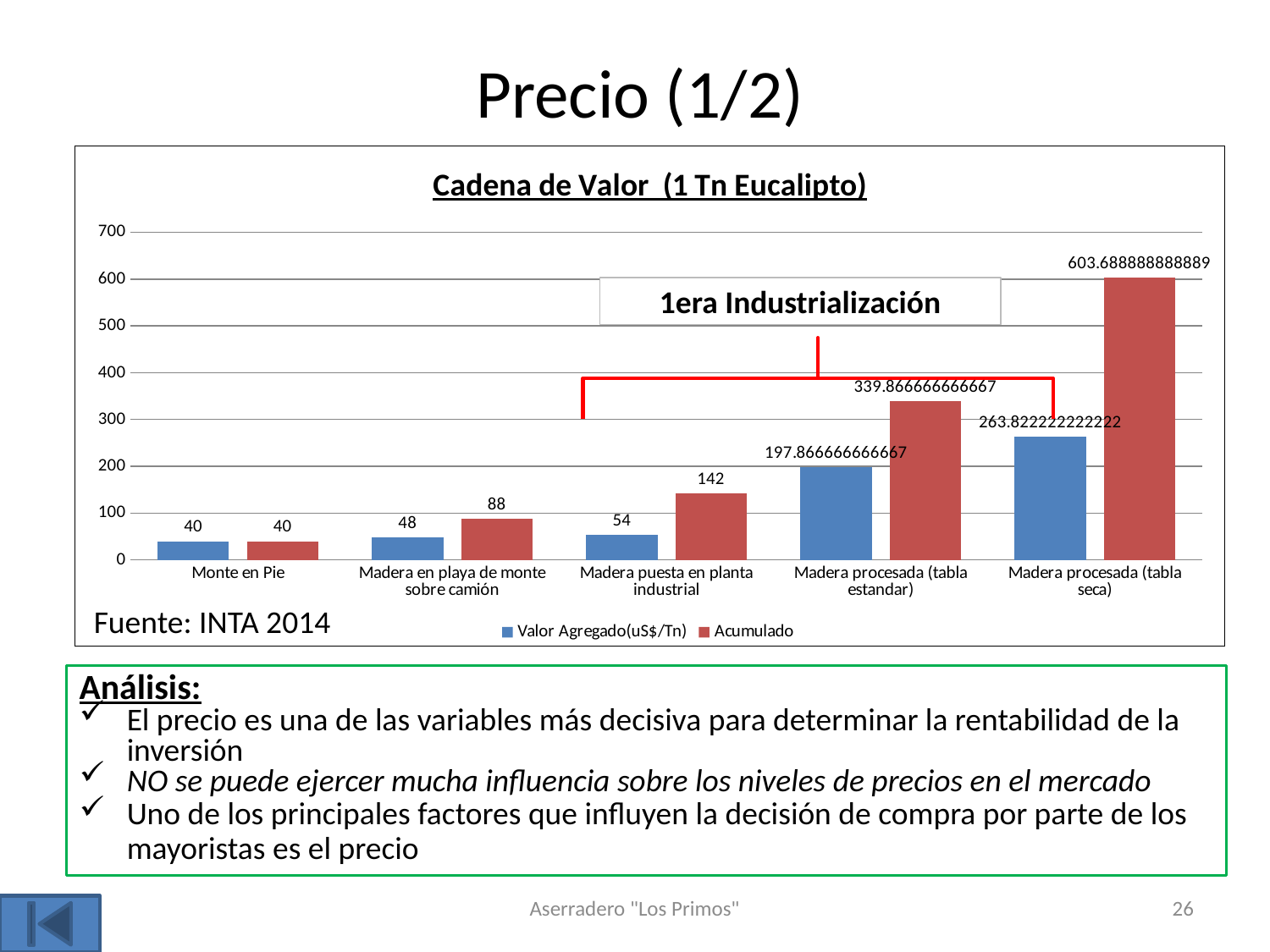
Do the Acumulado values rise or fall from left to right along the x axis? rise What type of chart is shown on the slide? bar chart What is the Acumulado value for Madera procesada (tabla seca)? 603.688888888889 Which category has the lowest Valor Agregado(uS$/Tn) value? Monte en Pie Which category has the highest Acumulado value? Madera procesada (tabla seca) What is the difference between the Acumulado values for Madera puesta en planta industrial and Madera en playa de monte sobre camión? 54 How many categories are shown on the x axis? 5 What is the Acumulado value for Madera en playa de monte sobre camión? 88 How many series does the legend list? 2 What is the title of the chart? Cadena de Valor (1 Tn Eucalipto) What is the Valor Agregado(uS$/Tn) value for Monte en Pie? 40 What is the Acumulado value for Madera puesta en planta industrial? 142